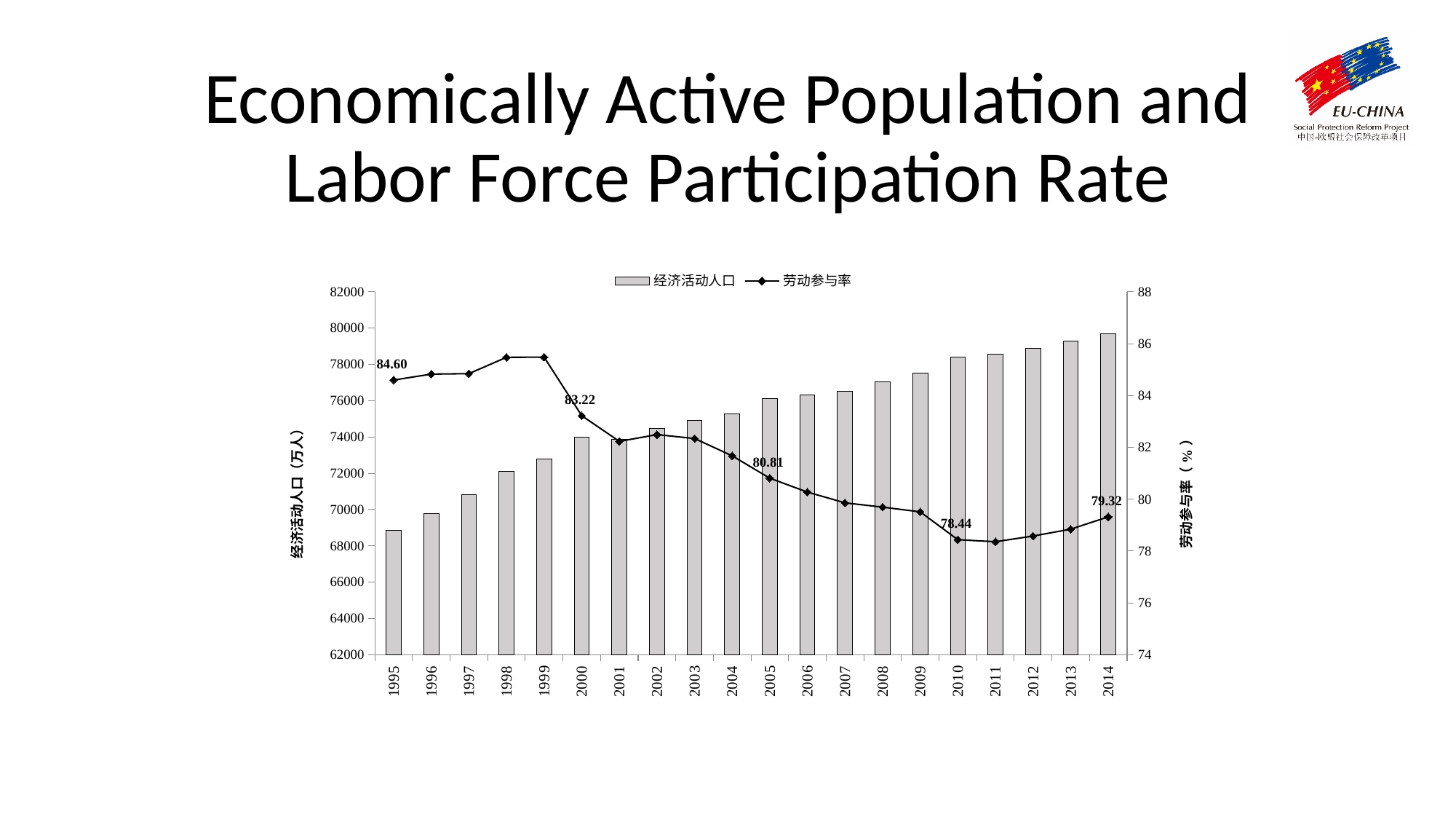
Which year has a higher labor force participation rate, 2000 or 2005? 2000 Is the economically active population (经济活动人口) bar for 1995 greater or less than 70000? less How many years are shown on the x axis of the chart? 20 By how much did the labor force participation rate fall from 1995 to 2010, using the printed labels? 6.16 What is the labor force participation rate (劳动参与率) shown for 2000? 83.22 What is the labor force participation rate (劳动参与率) shown for 2010? 78.44 What is the labor force participation rate (劳动参与率) shown for 2005? 80.81 Is the economically active population (经济活动人口) bar for 2014 greater or less than 78000? greater How many series does the chart's legend list? 2 What is the labor force participation rate (劳动参与率) shown for 2014? 79.32 What is the labor force participation rate (劳动参与率) shown for 1995? 84.60 Which year has the tallest economically active population bar? 2014